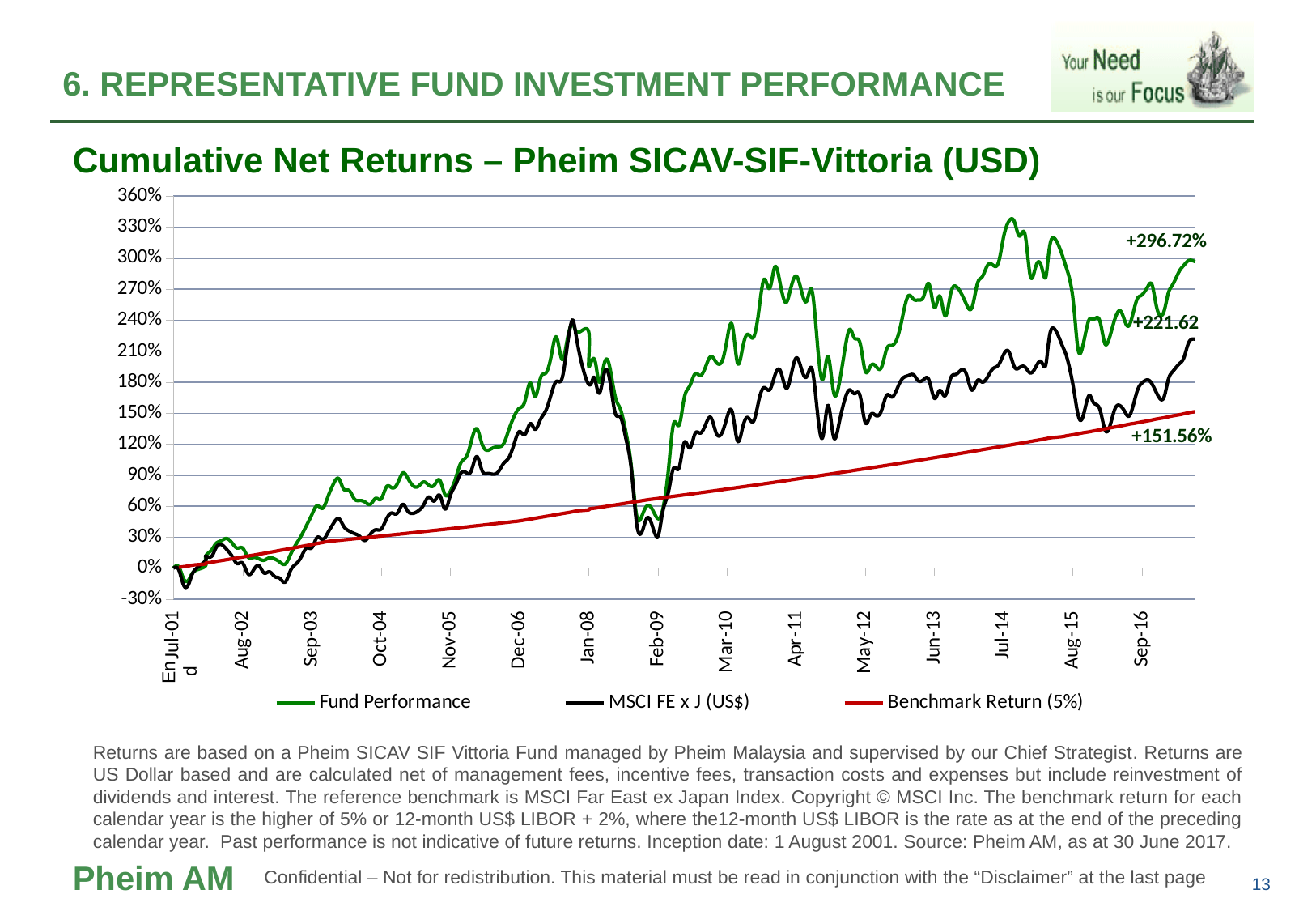
By how many percentage points does the final Fund Performance return exceed the final Benchmark Return (5%)? 145.16 percentage points How many series does the legend list? 3 Which series ends with the lowest cumulative return? Benchmark Return (5%) Which series ends with the highest cumulative return? Fund Performance At the end of the period, which is larger: Fund Performance or MSCI FE x J (US$)? Fund Performance What is the final cumulative net return shown for Fund Performance? +296.72% What is the final cumulative return shown for the Benchmark Return (5%) line? +151.56% Is the Fund Performance value at Feb-09 greater or less than 90%? less Is the Benchmark Return (5%) value at Sep-16 greater or less than 120%? greater What value is labelled at the end of the MSCI FE x J (US$) line? +221.62 What kind of chart is shown on the slide? Line chart Does the Benchmark Return (5%) line rise or fall over the period shown? Rises